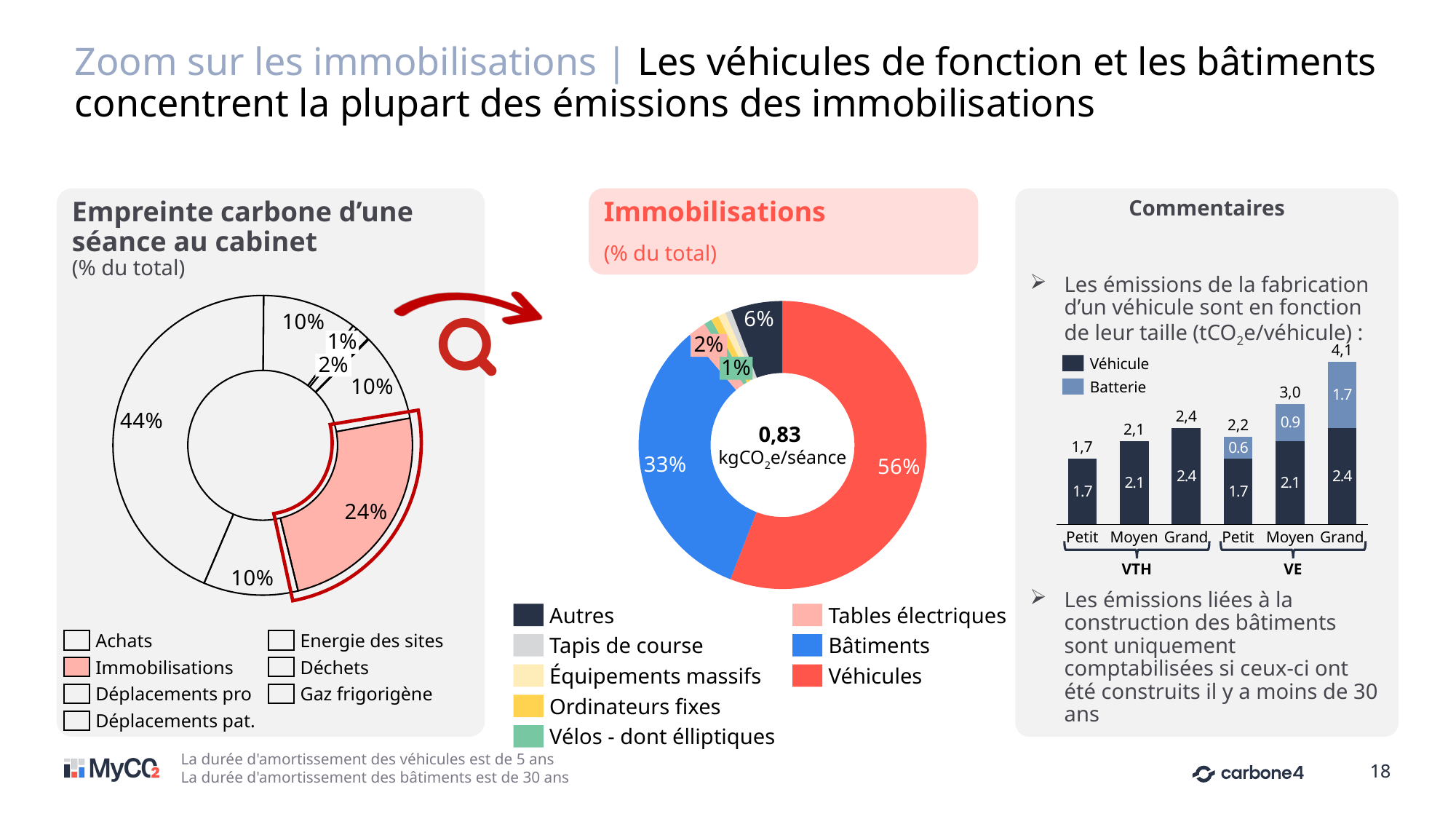
What kind of chart is the 'Empreinte carbone d'une séance au cabinet' chart? Donut (pie) chart In the 'Immobilisations' chart, what is the difference between the Véhicules share and the Bâtiments share? 23% In the bar chart in the Commentaires panel, what is the Batterie value for the Moyen VE bar? 0.9 In the 'Immobilisations' chart, which is larger: Autres or Tables électriques? Autres In the 'Immobilisations' chart, what share do Véhicules represent? 56% What value is printed in the centre of the 'Immobilisations' donut chart? 0,83 kgCO2e/séance In the 'Immobilisations' chart, what share do Bâtiments represent? 33% In the 'Empreinte carbone d'une séance au cabinet' chart, what share of the total do Immobilisations represent? 24% In the bar chart in the Commentaires panel, what is the total for the Grand VE bar? 4,1 In the 'Empreinte carbone d'une séance au cabinet' chart, what is the smallest percentage shown? 1% In the 'Empreinte carbone d'une séance au cabinet' chart, what is the largest percentage shown? 44% How many series does the legend of the bar chart in the Commentaires panel list? 2